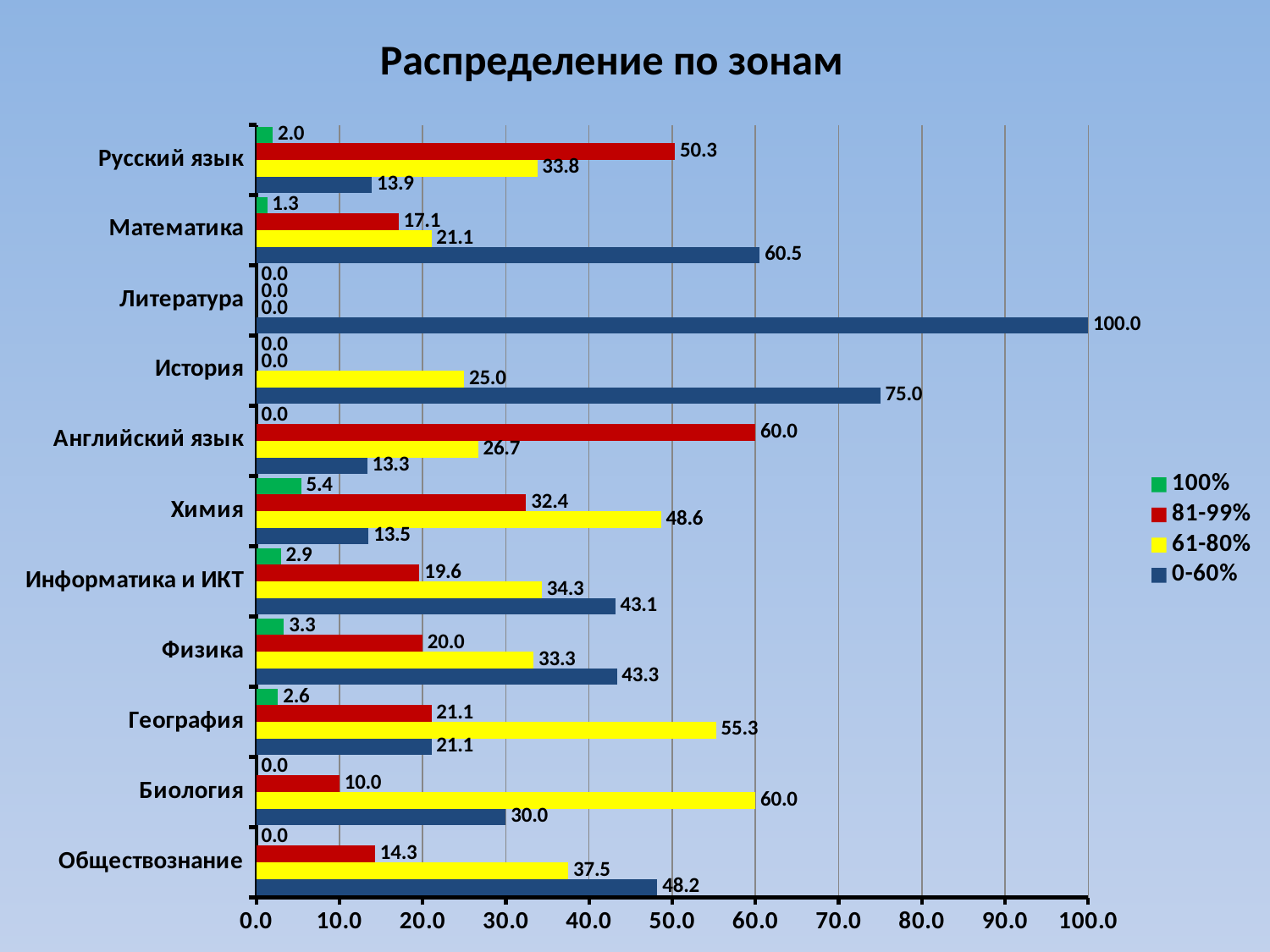
How many subject categories are shown on the chart? 11 Which is larger: the 61-80% value for Химия or the 61-80% value for Физика? Химия What is the title of the chart? Распределение по зонам What is the difference between the 0-60% value for Математика and the 0-60% value for Русский язык? 46.6 What is the value of the 81-99% series for Английский язык? 60.0 What is the value of the 61-80% series for География? 55.3 What is the value of the 0-60% series for Литература? 100.0 What type of chart is shown on the slide? Bar chart How many series does the legend list? 4 What is the value of the 81-99% series for Биология? 10.0 Which subject has the highest value in the 0-60% series? Литература Which subject has the highest value in the 100% series? Химия